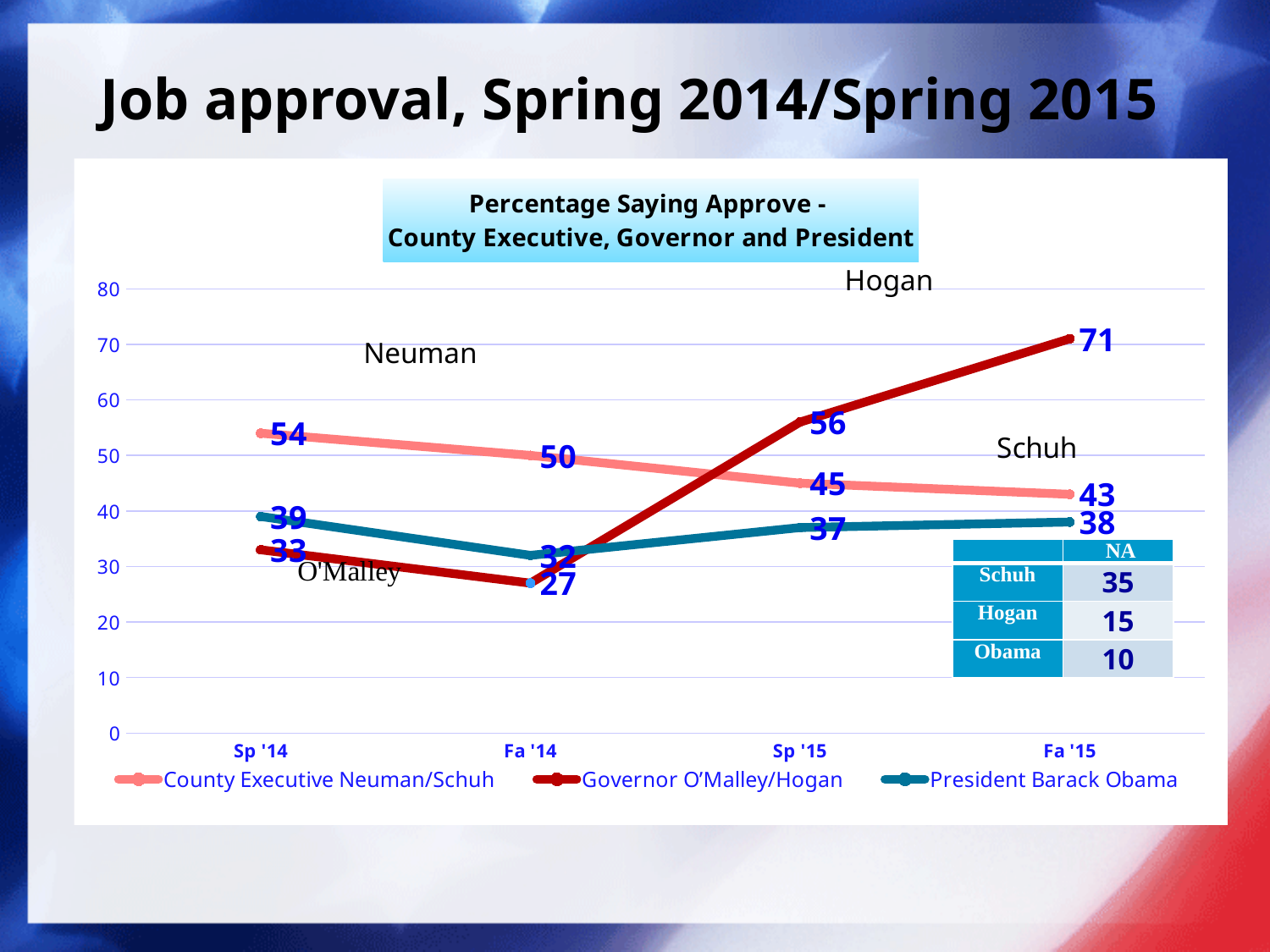
At which time point is the Governor O'Malley/Hogan series lowest? Fa '14 How many time points are shown on the x axis? 4 Which is larger at Sp '15: the Governor O'Malley/Hogan value or the County Executive Neuman/Schuh value? Governor O'Malley/Hogan Does the County Executive Neuman/Schuh series rise or fall from Sp '14 to Fa '15? fall What is the title of the chart? Percentage Saying Approve - County Executive, Governor and President At which time point is the County Executive Neuman/Schuh series highest? Sp '14 How many series does the legend list? 3 What is the approval value for Governor O'Malley/Hogan at Fa '15? 71 What is the approval value for County Executive Neuman/Schuh at Sp '14? 54 What is the difference between the Governor O'Malley/Hogan value at Fa '15 and at Sp '14? 38 What type of chart is shown on the slide? line chart What is the approval value for President Barack Obama at Fa '14? 32